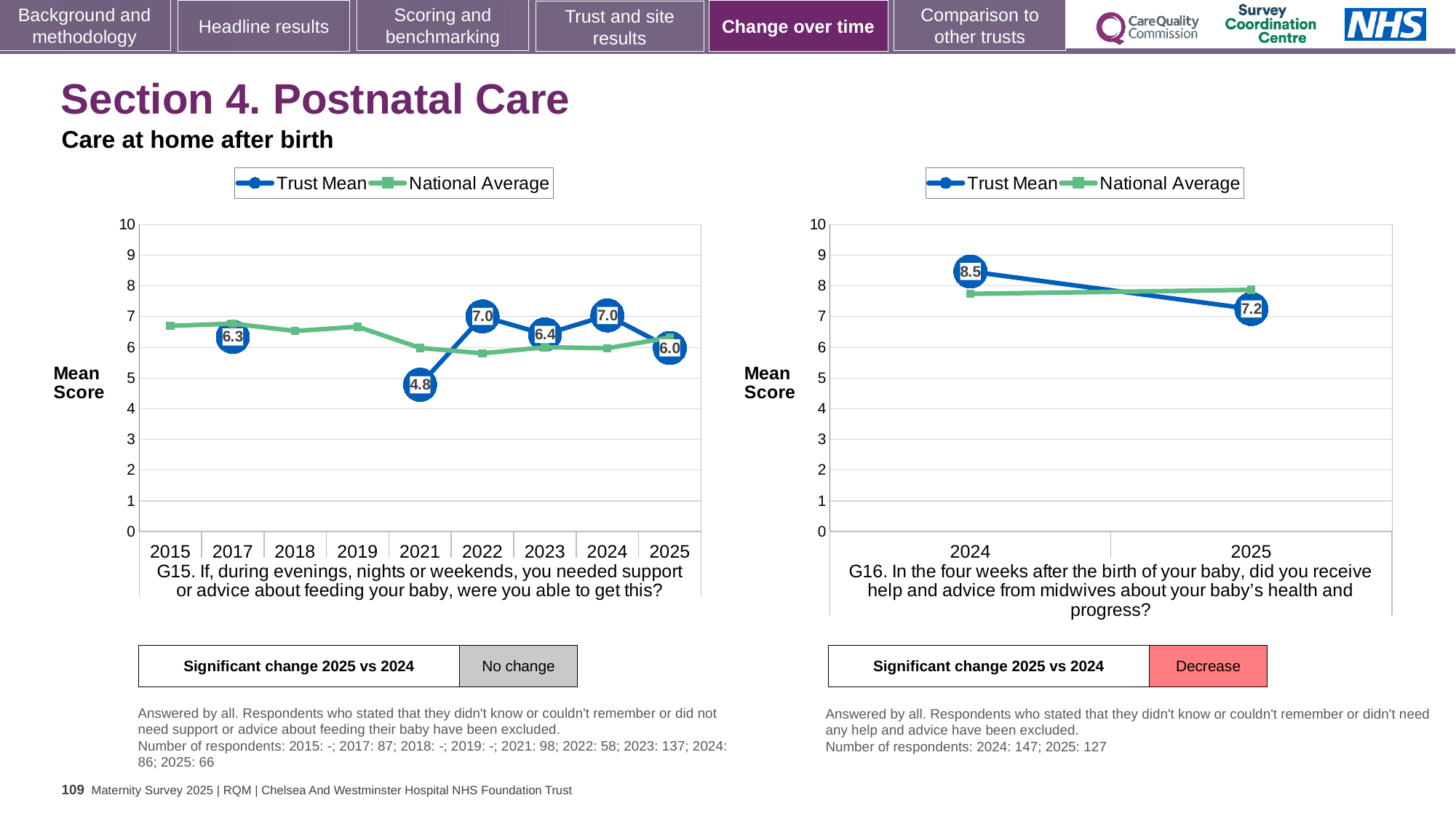
In the G16 chart on the right, what is the Trust Mean score for 2024? 8.5 In the G16 chart on the right, does the Trust Mean rise or fall from 2024 to 2025? fall In the G15 chart on the left, how many years are shown on the x axis? 9 How many series does the legend of the G16 chart on the right list? 2 In the G15 chart on the left, is the Trust Mean score for 2023 greater or less than the Trust Mean score for 2021? greater In the G15 chart on the left, what is the Trust Mean score for 2021? 4.8 In the G15 chart on the left, which year has the lowest Trust Mean score? 2021 In the G15 chart on the left, what is the Trust Mean score for 2025? 6.0 In the G15 chart on the left, is the National Average for 2015 greater or less than 6? greater What type of chart is the G15 chart on the left? line chart In the G16 chart on the right, what is the difference between the Trust Mean scores for 2024 and 2025? 1.3 In the G15 chart on the left, what is the difference between the Trust Mean scores for 2024 and 2025? 1.0